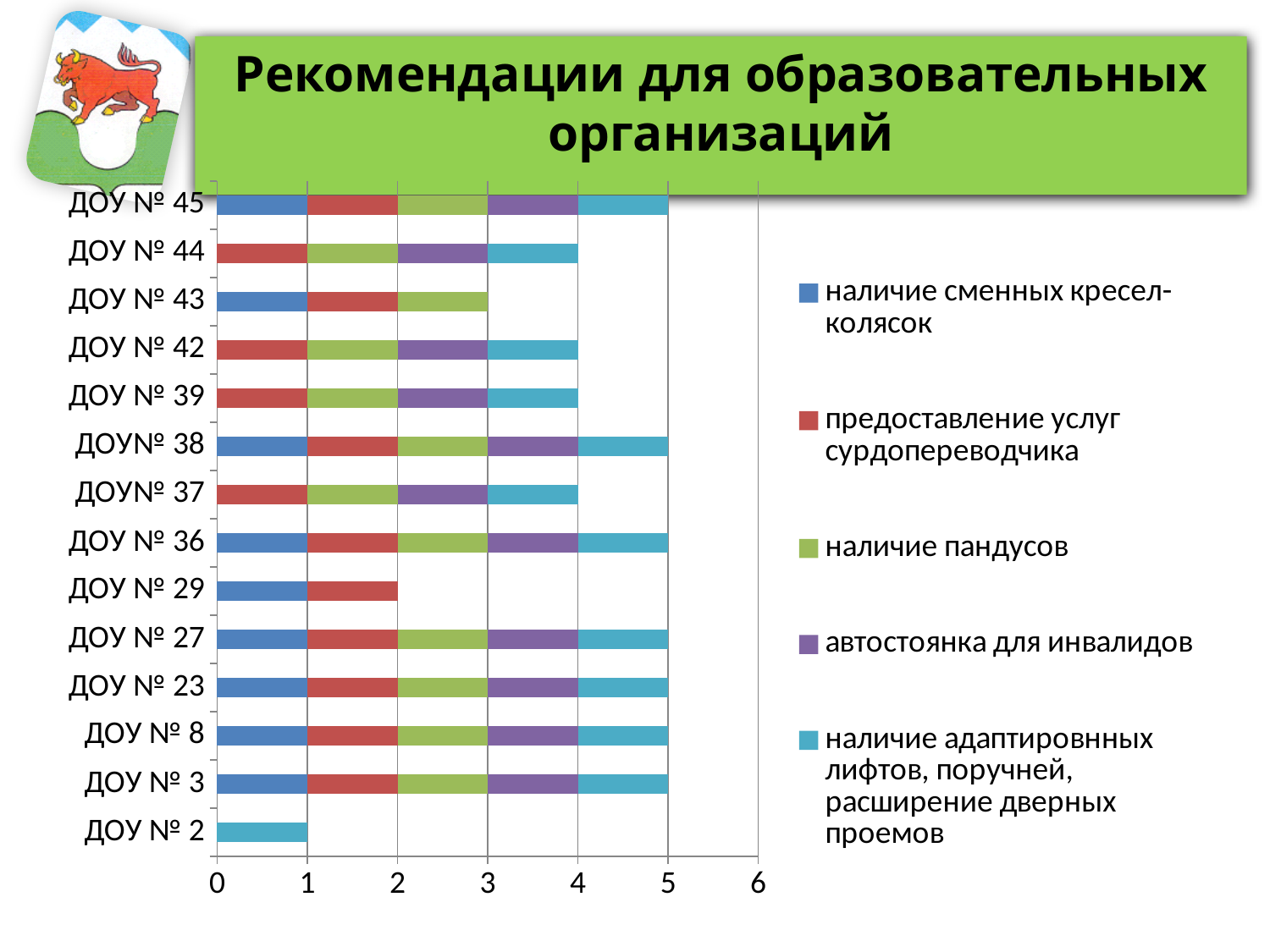
Which legend entry is shown in green? наличие пандусов What is the total length of the stacked bar for ДОУ № 2? 1 Which has the longer stacked bar, ДОУ № 36 or ДОУ № 37? ДОУ № 36 Is the total for ДОУ № 44 greater or less than 5? less What is the total length of the stacked bar for ДОУ № 29? 2 Which category has the shortest stacked bar? ДОУ № 2 How many categories (ДОУ) are shown on the vertical axis? 14 What is the total length of the stacked bar for ДОУ № 43? 3 How many series does the legend list? 5 What is the difference between the total bar lengths of ДОУ № 38 and ДОУ № 29? 3 What kind of chart is shown on the slide? stacked bar chart